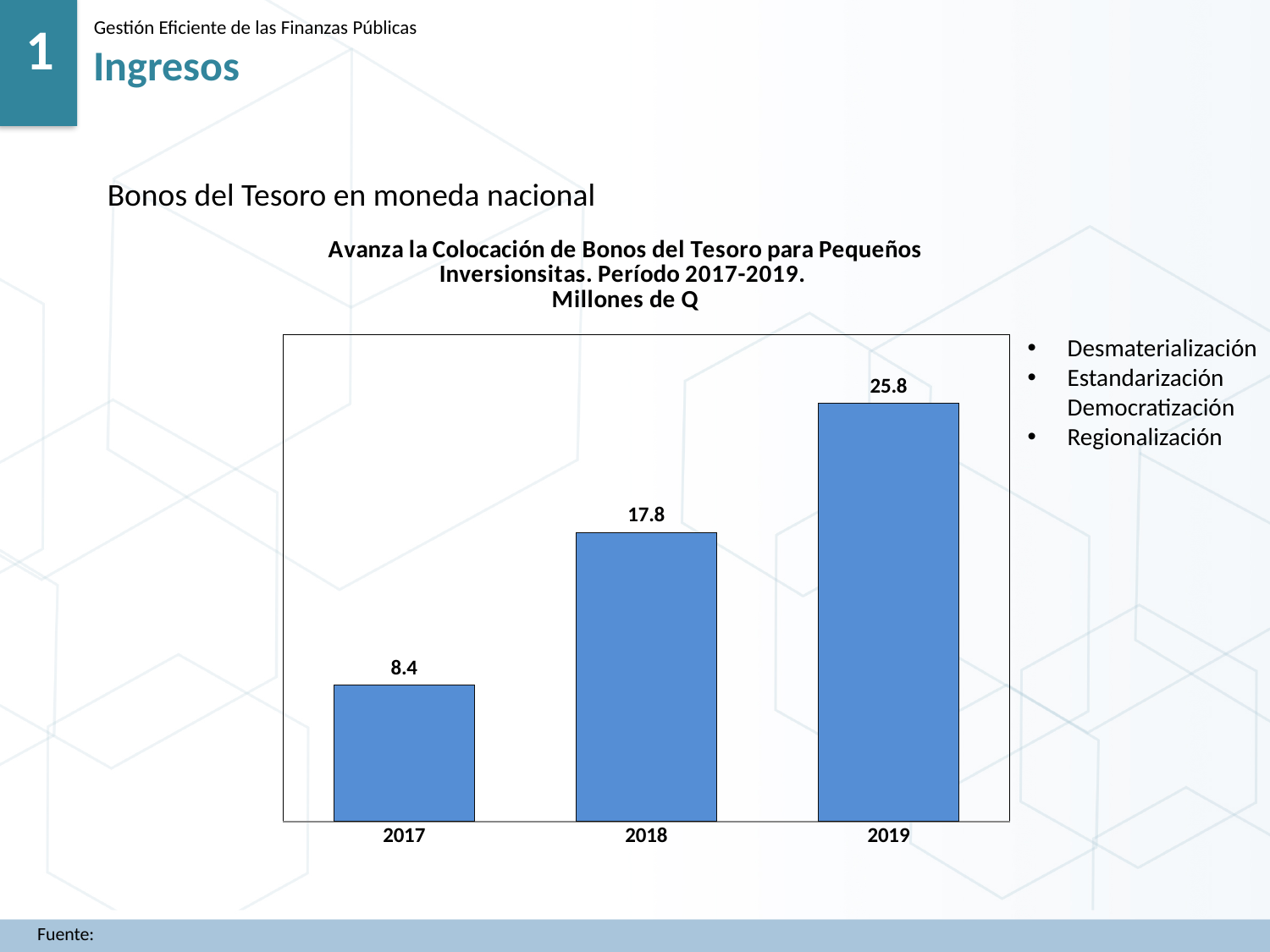
Which year has the lowest value? 2017 What is the difference between the values for 2018 and 2017? 9.4 What is the value for 2018? 17.8 Which year has the highest value? 2019 How many years are shown on the x axis? 3 What is the value for 2019? 25.8 Do the values rise or fall from 2017 to 2019? rise What is the difference between the values for 2019 and 2017? 17.4 What is the value for 2017? 8.4 In what unit are the values expressed according to the chart title? Millones de Q What kind of chart is this? bar chart Which is larger, the value for 2018 or the value for 2019? 2019